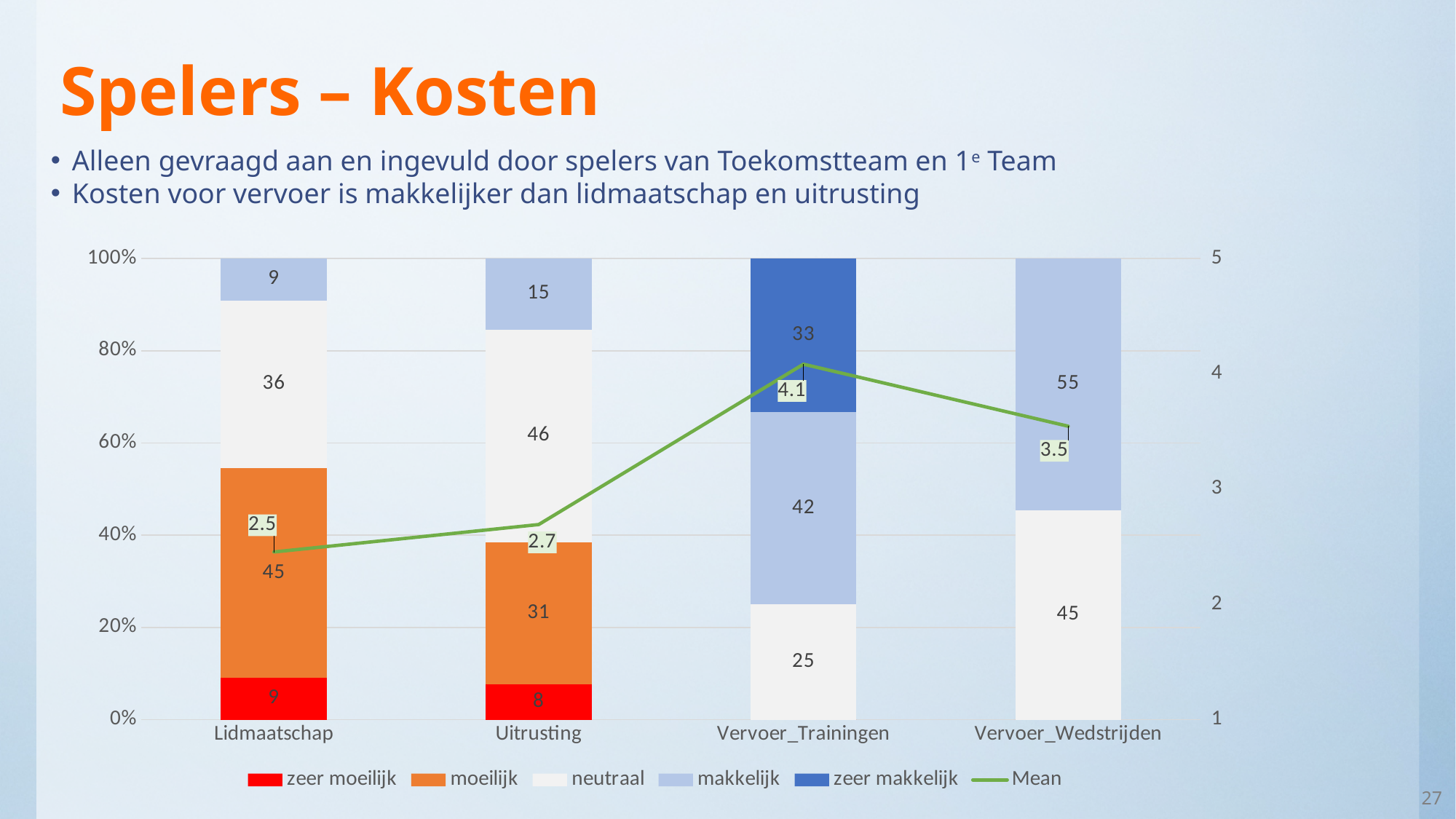
How many series does the legend list? 6 What is the Mean value for Vervoer_Trainingen? 4.1 What is the 'makkelijk' value for Vervoer_Wedstrijden? 55 How many categories are shown on the x axis? 4 What is the 'neutraal' value for Uitrusting? 46 Which category has the lowest Mean value? Lidmaatschap Which series is drawn as a green line? Mean Which is larger: the 'zeer moeilijk' value for Lidmaatschap or for Uitrusting? Lidmaatschap What is the 'moeilijk' value for Lidmaatschap? 45 Which category has the highest Mean value? Vervoer_Trainingen What is the difference between the 'moeilijk' values for Lidmaatschap and Uitrusting? 14 What kind of chart is shown on the slide? Stacked bar chart with a line